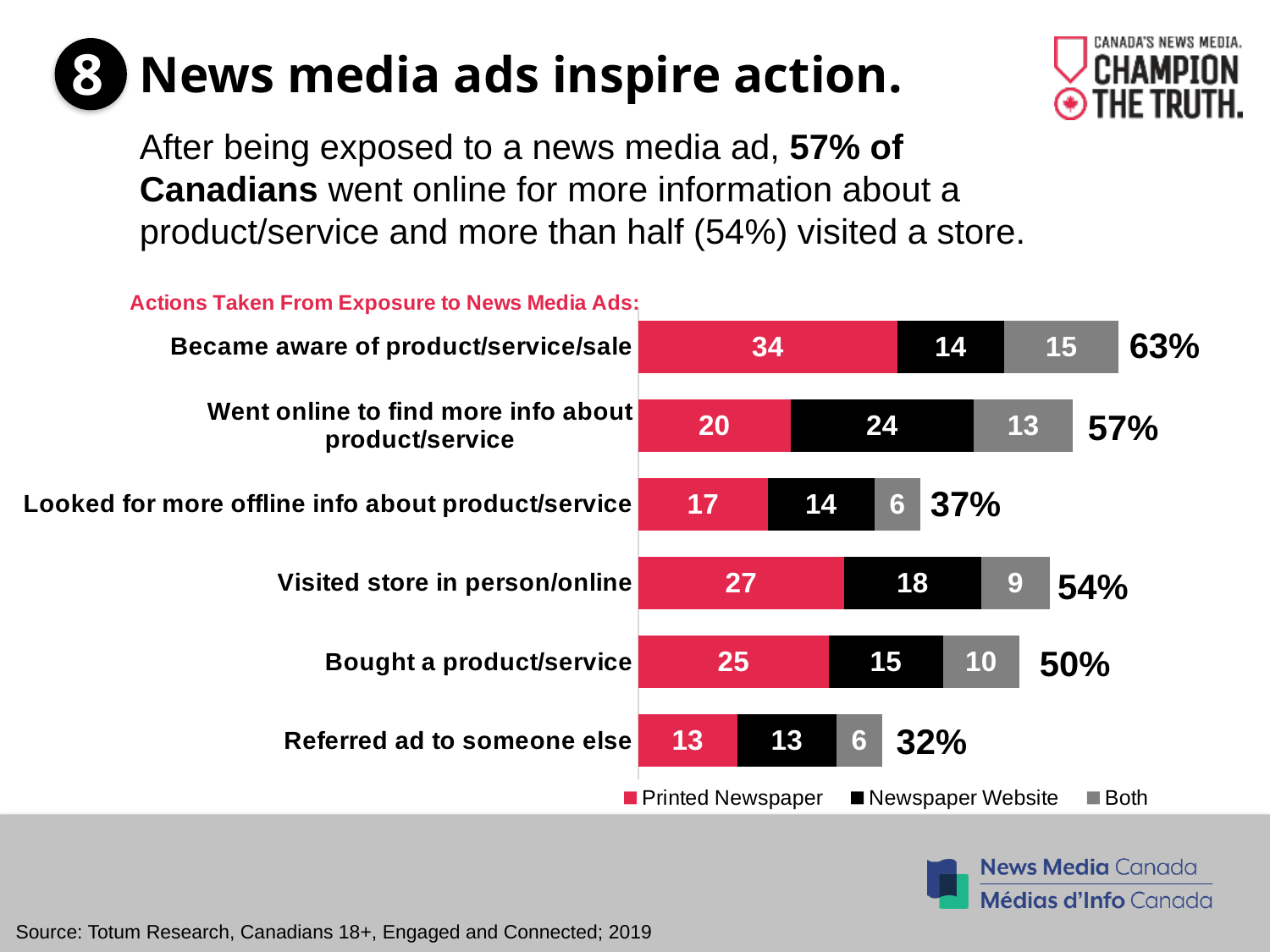
What kind of chart is shown on the slide? stacked bar chart What is the difference between the Printed Newspaper value for 'Visited store in person/online' and the Printed Newspaper value for 'Referred ad to someone else'? 14 How many action categories are plotted in the chart? 6 How many series does the legend list? 3 What is the Newspaper Website value for 'Went online to find more info about product/service'? 24 What is the Printed Newspaper value for 'Became aware of product/service/sale'? 34 What is the 'Both' value for 'Visited store in person/online'? 9 Which action has the lowest total percentage? Referred ad to someone else Which is larger: the Newspaper Website value for 'Went online to find more info about product/service' or the Newspaper Website value for 'Bought a product/service'? Went online to find more info about product/service What is the title of the chart? Actions Taken From Exposure to News Media Ads Which action has the highest total percentage? Became aware of product/service/sale What is the total shown for 'Bought a product/service'? 50%